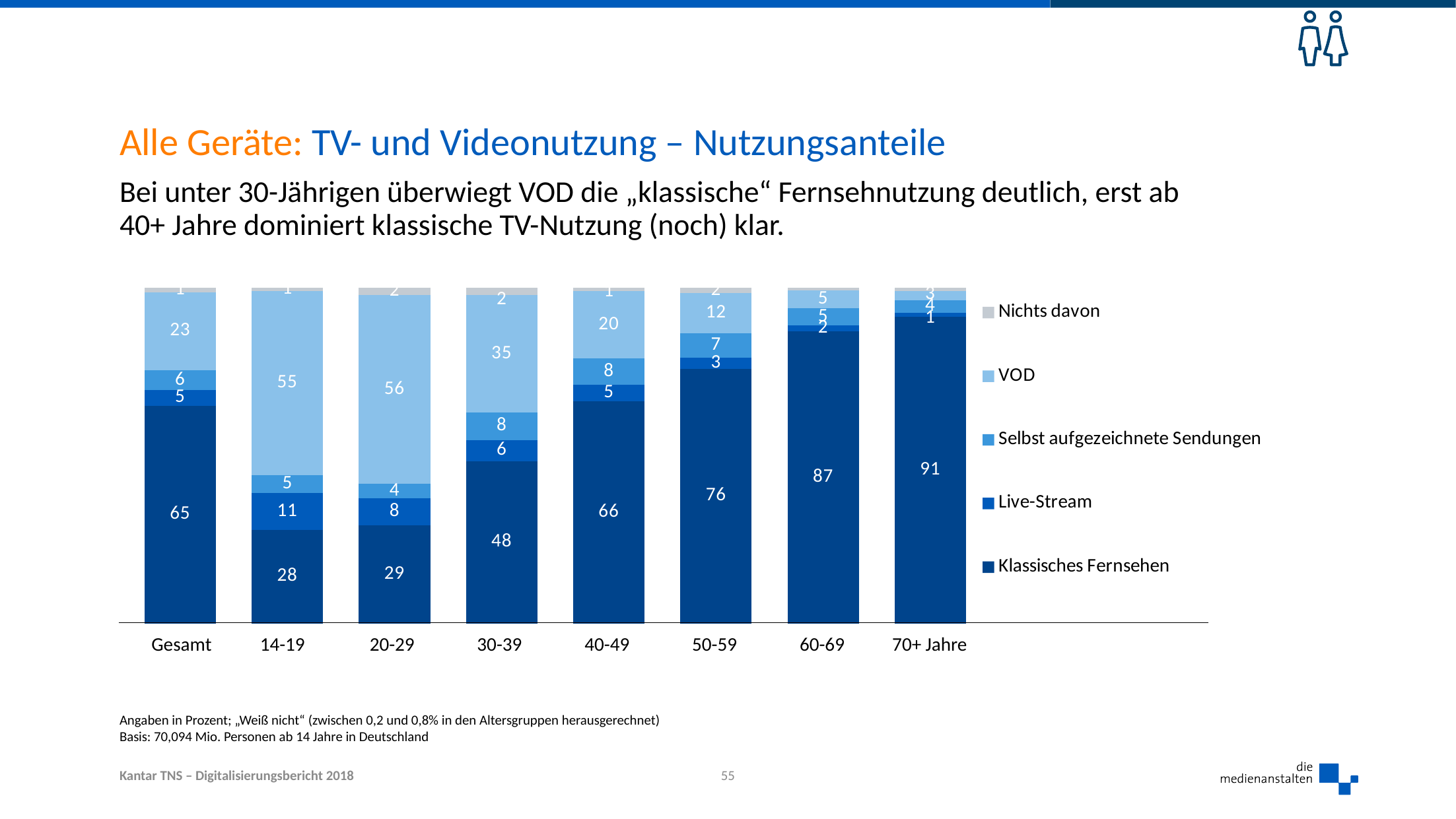
Does the value for Klassisches Fernsehen rise or fall from the 14-19 group to the 70+ Jahre group? Rise What is the Live-Stream value for the Gesamt category? 5 Which age group has the lowest value for Klassisches Fernsehen? 14-19 What is the VOD value for the 20-29 age group? 56 What kind of chart is shown on the slide? Stacked bar chart Which has the larger Live-Stream value, the 14-19 group or the 20-29 group? 14-19 What is the value for Klassisches Fernsehen in the 30-39 age group? 48 What is the value for Selbst aufgezeichnete Sendungen in the 40-49 age group? 8 How many series does the legend list? 5 How many categories are shown on the x axis? 8 What is the difference between the VOD value for 14-19 and the VOD value for 50-59? 43 Which age group has the highest value for Klassisches Fernsehen? 70+ Jahre